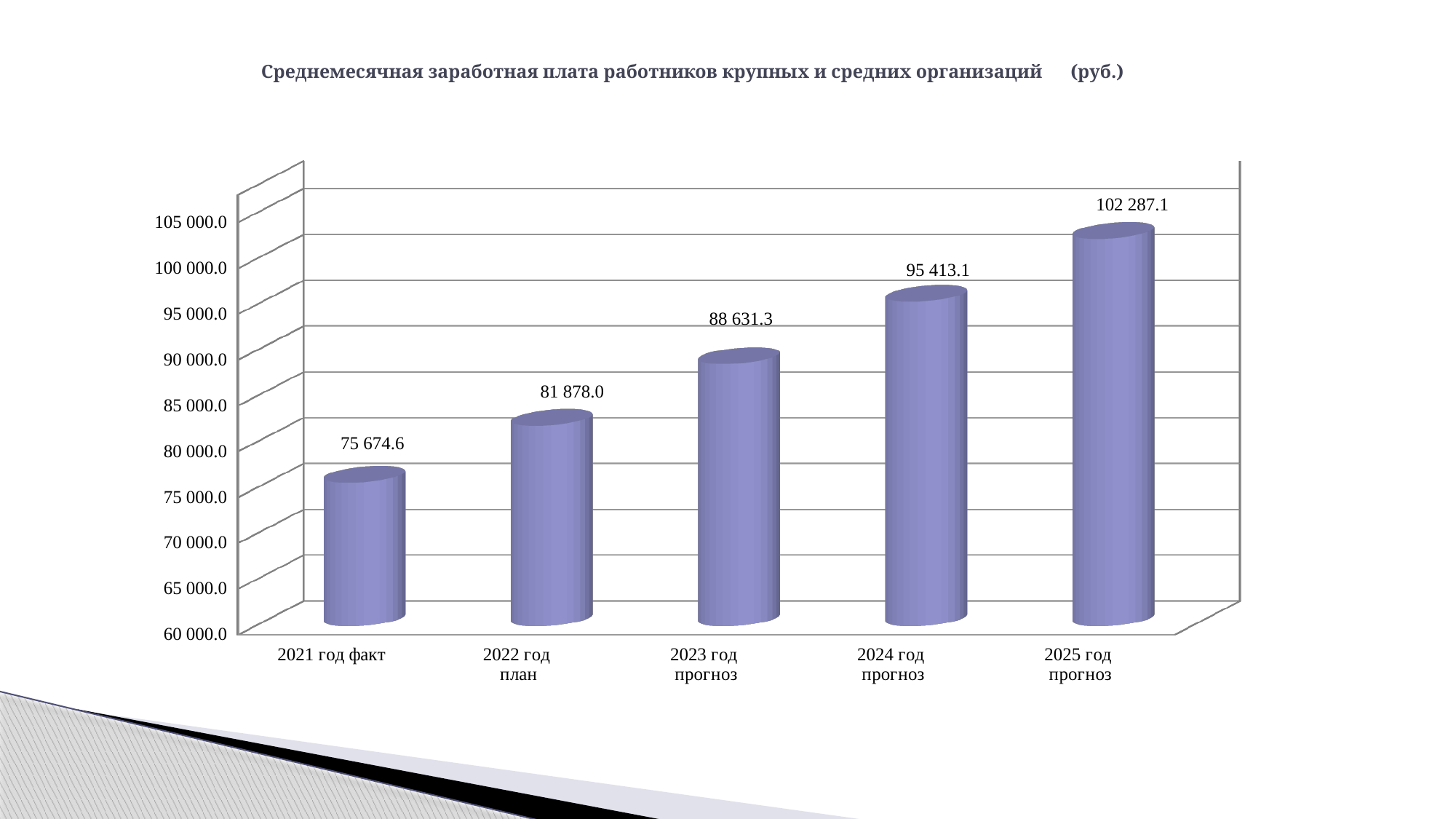
What is the difference between the values for 2022 год план and 2021 год факт? 6 203.4 What is the value for 2021 год факт? 75 674.6 What kind of chart is shown on the slide? bar chart Which is larger, the value for 2024 год прогноз or the value for 2022 год план? 2024 год прогноз What is the value for 2023 год прогноз? 88 631.3 What is the difference between the values for 2025 год прогноз and 2021 год факт? 26 612.5 Which category has the lowest value? 2021 год факт Is the value for 2023 год прогноз greater or less than 90 000.0? less What is the value for 2025 год прогноз? 102 287.1 Which category has the highest value? 2025 год прогноз Do the values rise or fall from 2021 год факт to 2025 год прогноз? rise How many categories are shown on the x axis? 5